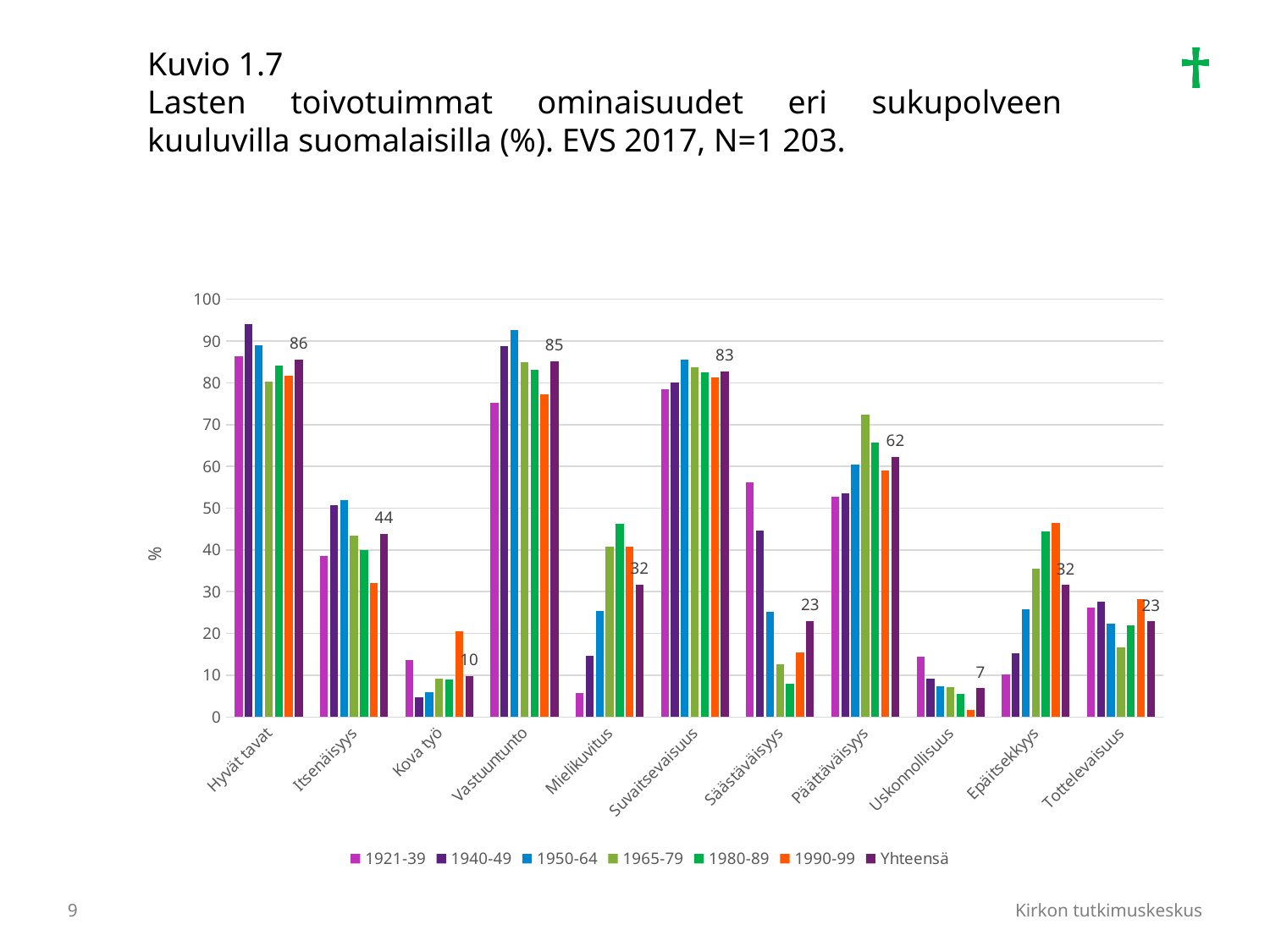
What is the difference between the Yhteensä values for Hyvät tavat and Uskonnollisuus? 79 Is the value for 1921-39 in Säästäväisyys greater or less than 50? greater Which category has the lowest Yhteensä value? Uskonnollisuus What is the Yhteensä value for Päättäväisyys? 62 Which category has the highest Yhteensä value? Hyvät tavat Is the value for 1940-49 in Hyvät tavat greater or less than 90? greater How many categories are shown on the x axis? 11 What is the Yhteensä value for Uskonnollisuus? 7 How many series does the legend list? 7 What kind of chart is shown on the slide? bar chart What is the Yhteensä value for Hyvät tavat? 86 Which has the larger Yhteensä value, Itsenäisyys or Epäitsekkyys? Itsenäisyys